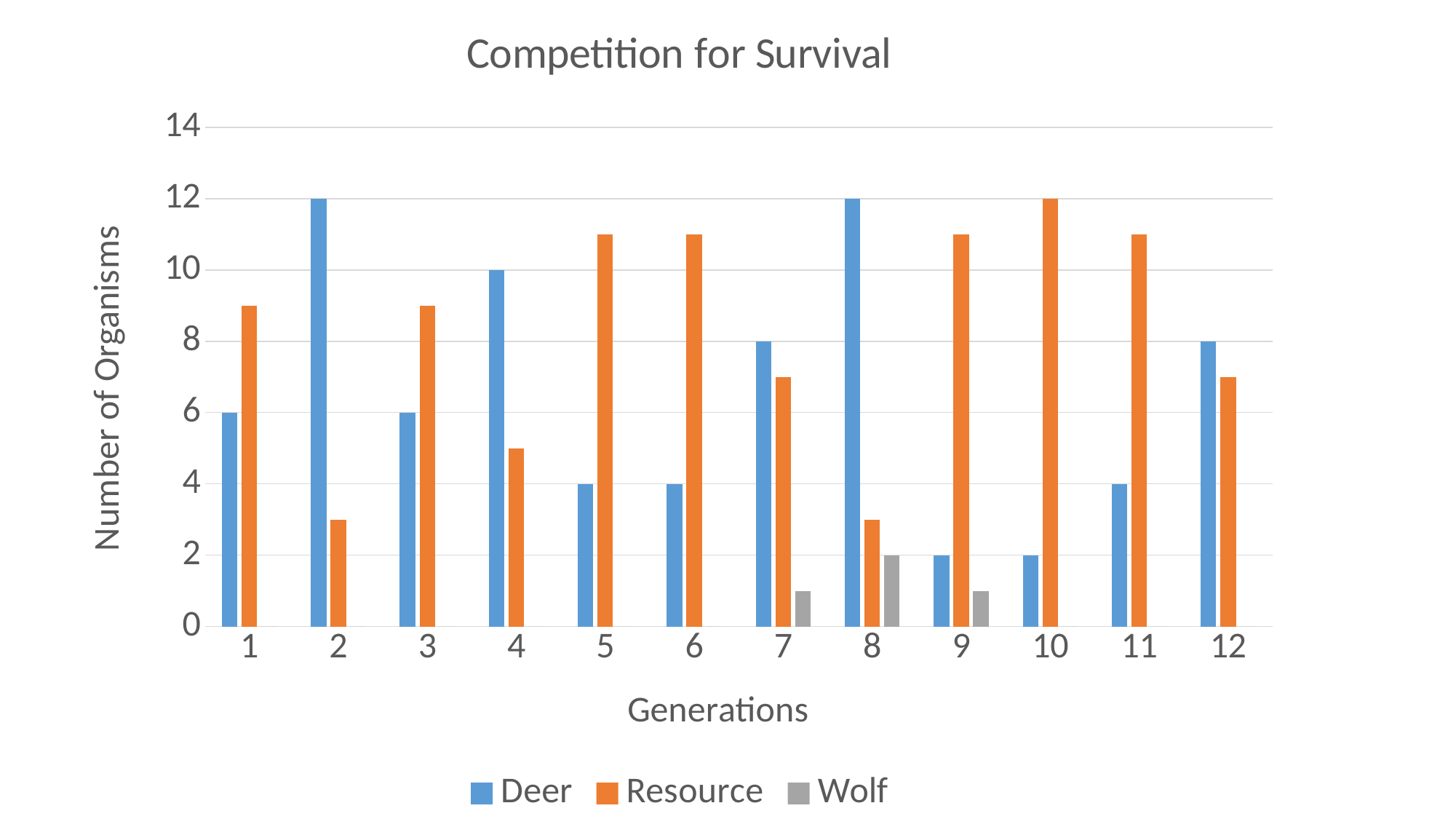
What is the number of Resource in generation 10? 12 How many generations are shown on the x axis? 12 What is the difference between Deer in generation 2 and Deer in generation 9? 10 What is the number of Wolf in generation 8? 2 What is the number of Deer in generation 2? 12 Is the value for Resource in generation 2 greater or less than 4? less What is the title of the chart? Competition for Survival In generation 8, which is larger, Deer or Resource? Deer Is the value for Resource in generation 5 greater or less than 10? greater What type of chart is shown on the slide? bar chart What is the number of Deer in generation 4? 10 How many series does the legend list? 3